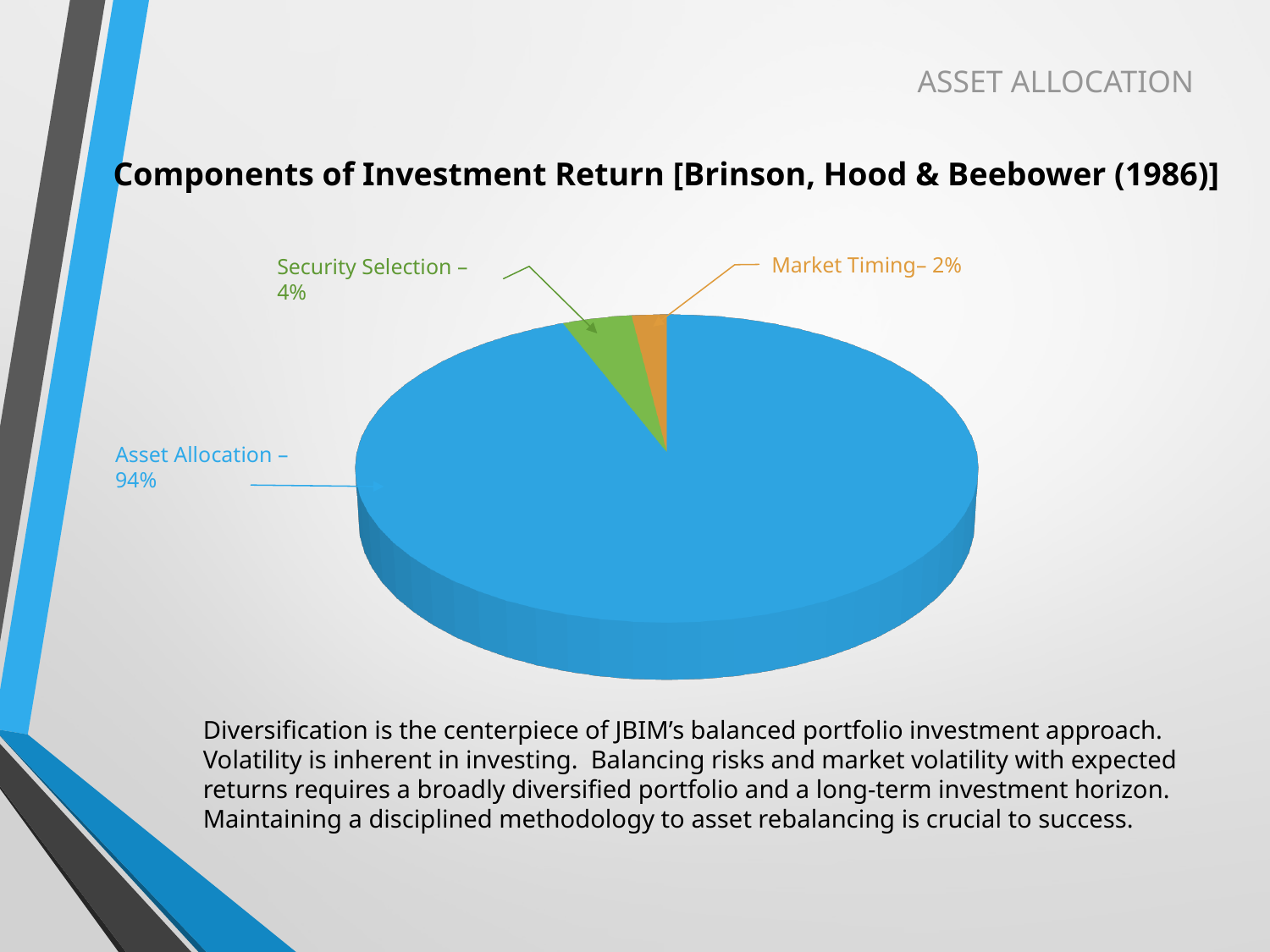
How many slices does the pie chart have? 3 What is the difference in percentage points between Security Selection and Market Timing? 2 What share of investment return is attributed to Security Selection? 4% What share of investment return is attributed to Market Timing? 2% What share of investment return is attributed to Asset Allocation? 94% What colour is the Security Selection slice? Green Which is larger, the share for Security Selection or the share for Market Timing? Security Selection Which component accounts for the largest share of investment return? Asset Allocation What kind of chart is shown on the slide? Pie chart What is the title of the chart? Components of Investment Return [Brinson, Hood & Beebower (1986)] What is the difference in percentage points between Asset Allocation and Security Selection? 90 Which component accounts for the smallest share of investment return? Market Timing